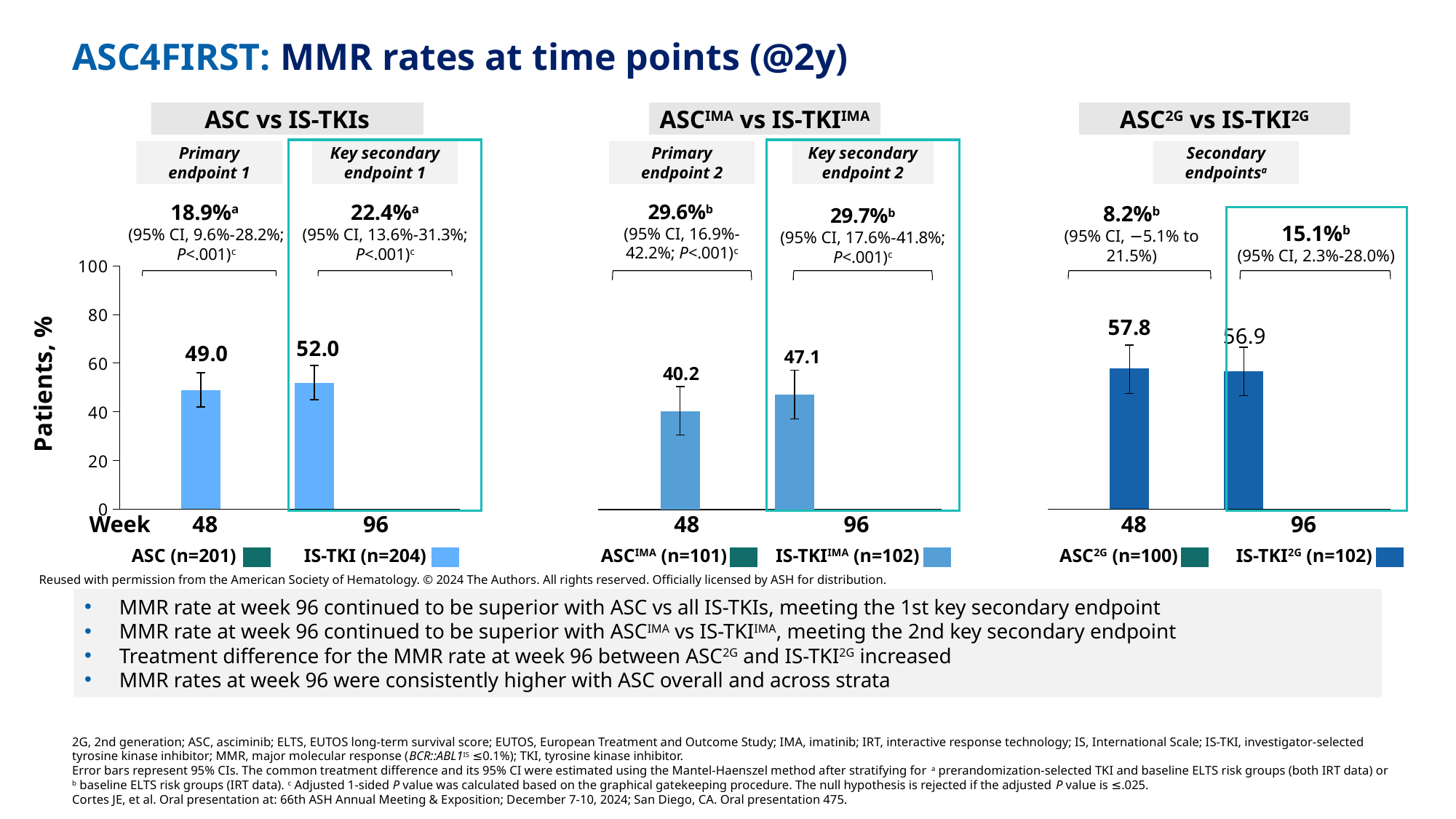
In the ASC IMA vs IS-TKI IMA chart, what is the value of the bar at week 96? 47.1 In the ASC vs IS-TKIs chart, what is the difference between the week 96 and week 48 bar values? 3.0 In the ASC IMA vs IS-TKI IMA chart, what is the value of the bar at week 48? 40.2 What kind of chart is used on this slide? bar chart In the ASC IMA vs IS-TKI IMA chart, what is the difference between the week 96 and week 48 bar values? 6.9 In the ASC IMA vs IS-TKI IMA chart, do the bar values rise or fall from week 48 to week 96? rise How many series does the legend of the ASC vs IS-TKIs chart list? 2 In the ASC 2G vs IS-TKI 2G chart, what is the value of the bar at week 48? 57.8 In the ASC 2G vs IS-TKI 2G chart, what treatment difference is printed above the week 96 bracket? 15.1% In the ASC 2G vs IS-TKI 2G chart, what is the value of the bar at week 96? 56.9 In the ASC vs IS-TKIs chart, what is the value of the bar at week 96? 52.0 In the ASC vs IS-TKIs chart, what is the value of the bar at week 48? 49.0